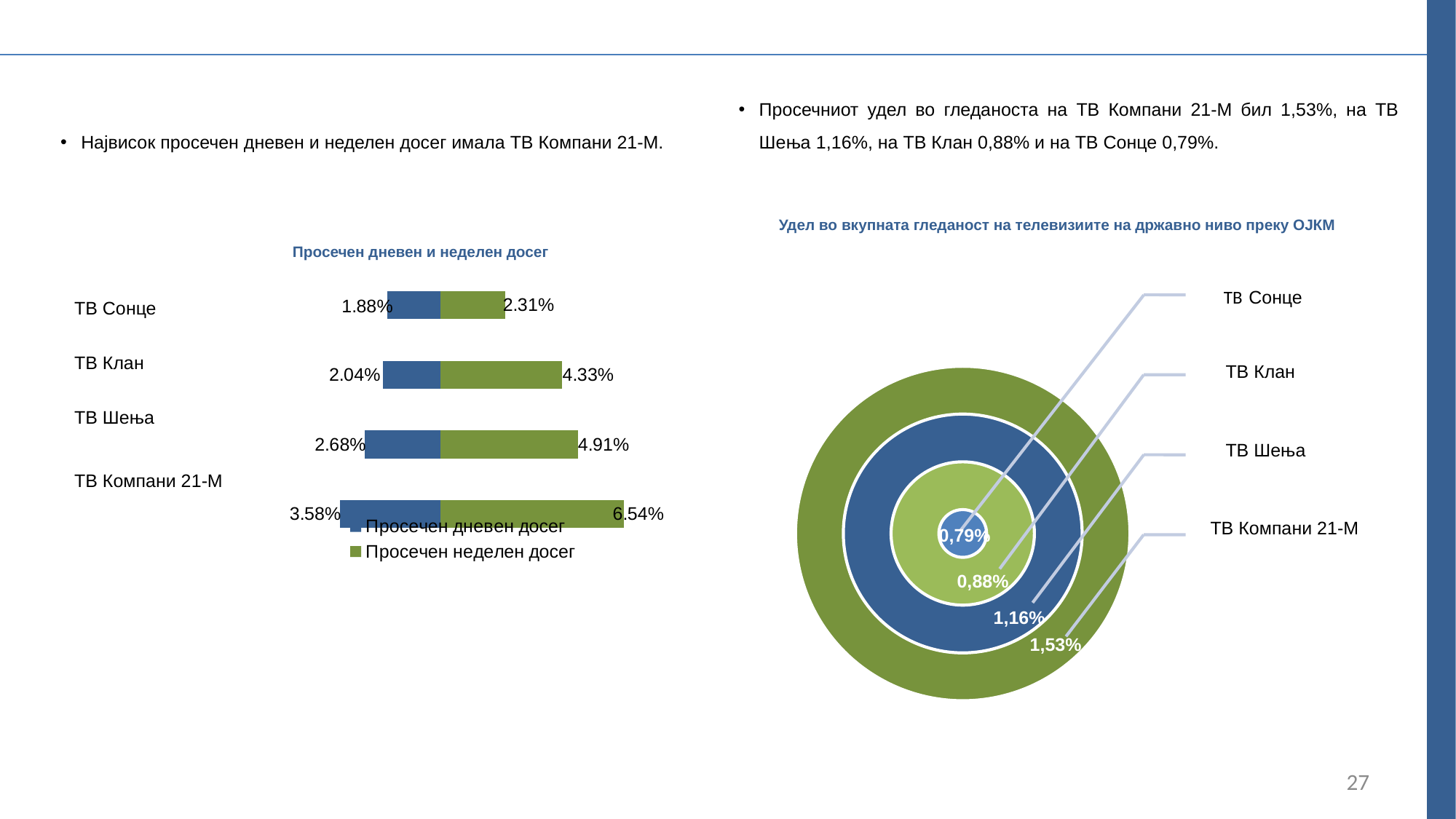
In the chart titled "Удел во вкупната гледаност на телевизиите на државно ниво преку ОЈКМ", what is the value for ТВ Шења? 1,16% In the chart titled "Просечен дневен и неделен досег", which is larger: the weekly reach of ТВ Сонце or the weekly reach of ТВ Клан? ТВ Клан In the chart titled "Просечен дневен и неделен досег", what is the average daily reach (Просечен дневен досег) for ТВ Компани 21-М? 3.58% In the chart titled "Просечен дневен и неделен досег", how many series does the legend list? 2 In the chart titled "Просечен дневен и неделен досег", what is the difference between the weekly reach and the daily reach for ТВ Шења? 2.23% In the chart titled "Удел во вкупната гледаност на телевизиите на државно ниво преку ОЈКМ", what is the difference between the share of ТВ Компани 21-М and the share of ТВ Клан? 0,65% In the chart titled "Просечен дневен и неделен досег", how many stations are shown? 4 In the chart titled "Просечен дневен и неделен досег", what is the average weekly reach (Просечен неделен досег) for ТВ Клан? 4.33% What kind of chart is the one titled "Просечен дневен и неделен досег"? Bar chart In the chart titled "Просечен дневен и неделен досег", which station has the lowest average daily reach? ТВ Сонце In the chart titled "Удел во вкупната гледаност на телевизиите на државно ниво преку ОЈКМ", which station has the lowest share? ТВ Сонце In the chart titled "Просечен дневен и неделен досег", which station has the highest average weekly reach? ТВ Компани 21-М